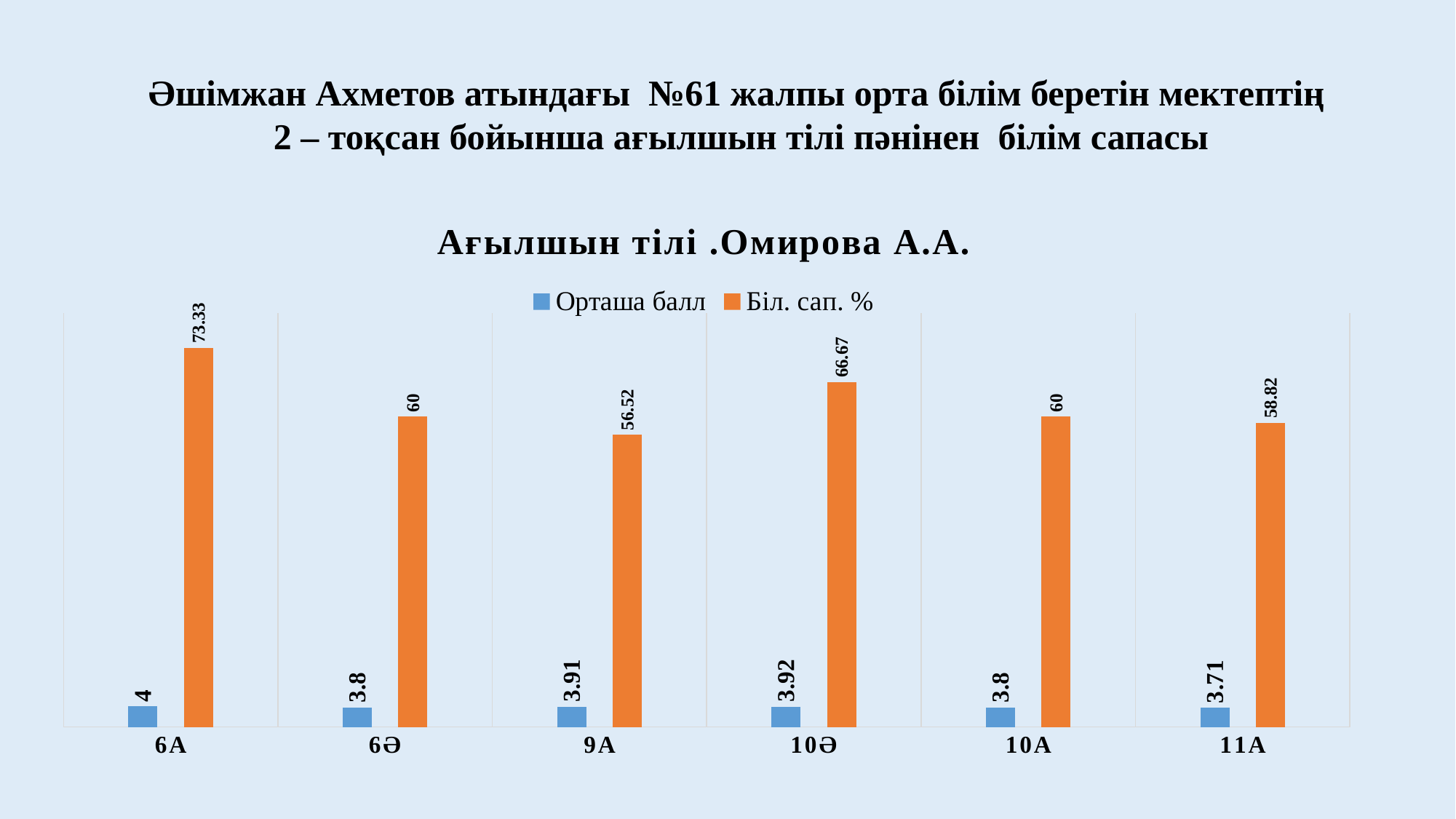
What is the Біл. сап. % value for 11А? 58.82 Which class has the lowest Біл. сап. % value? 9А What kind of chart is shown? bar chart Which is larger, the Біл. сап. % value for 10Ә or for 11А? 10Ә Which class has the lowest Орташа балл value? 11А What is the title of the chart? Ағылшын тілі .Омирова А.А. Which class has the highest Біл. сап. % value? 6А What is the Біл. сап. % value for 6А? 73.33 How many series does the legend list? 2 How many classes are shown on the x axis? 6 What is the difference between the Біл. сап. % values for 6А and 10Ә? 6.66 What is the Орташа балл value for 9А? 3.91